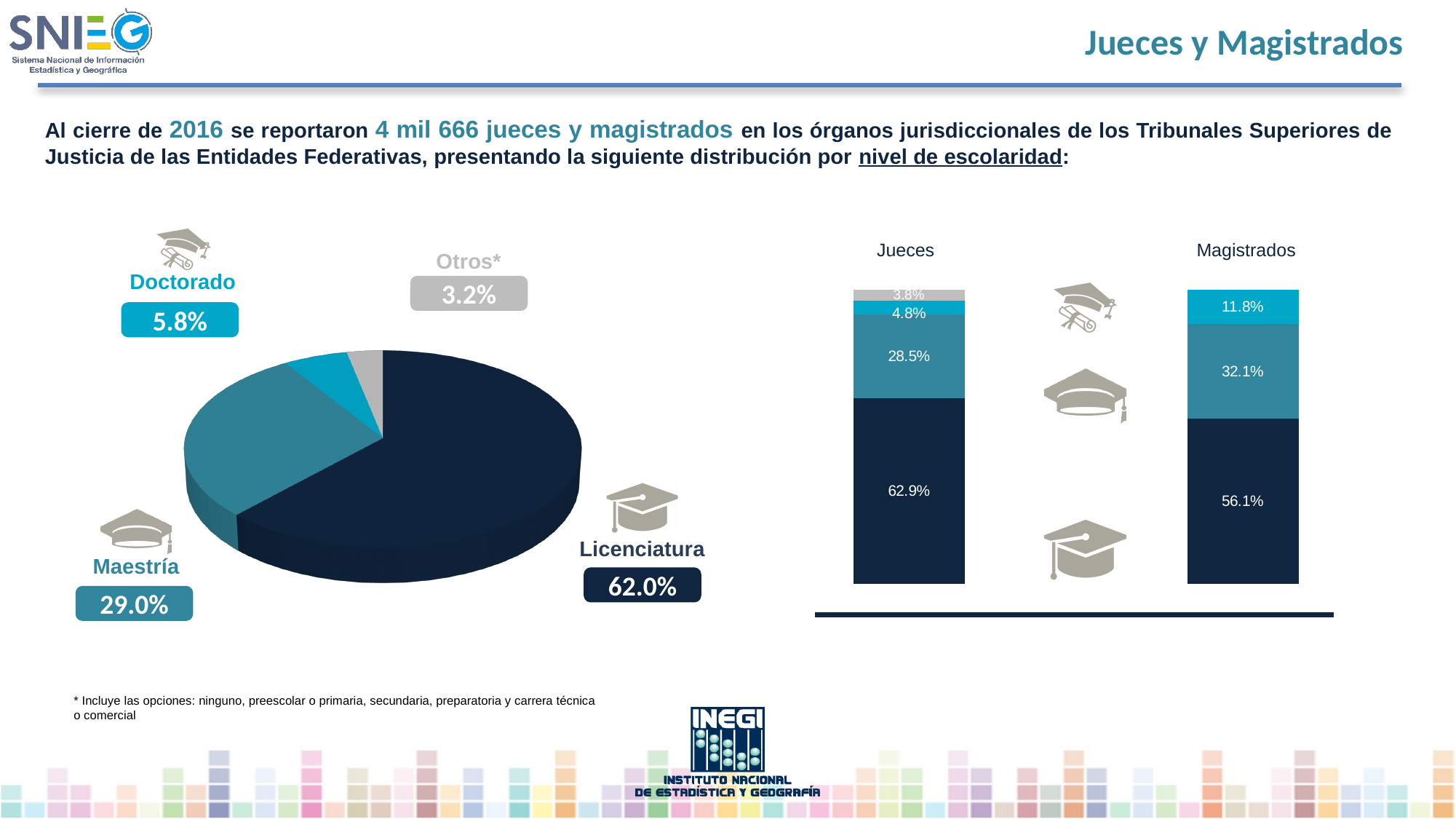
In the pie chart on the left, what percentage corresponds to Maestría? 29.0% In the stacked bar chart on the right, what is the value of the bottom (dark navy) segment for Jueces? 62.9% In the pie chart on the left, what percentage corresponds to Doctorado? 5.8% In the pie chart on the left, which education level has the largest share? Licenciatura In the stacked bar chart on the right, what is the value of the top (light blue) segment for Magistrados? 11.8% What type of chart is shown on the left side of the slide? Pie chart In the stacked bar chart on the right, what is the difference between the teal segment for Magistrados (32.1%) and the teal segment for Jueces (28.5%)? 3.6 percentage points In the pie chart on the left, what share of judges and magistrates have a Licenciatura? 62.0% In the pie chart on the left, which education level has the smallest share? Otros* In the stacked bar chart on the right, which group has the larger bottom (dark navy) segment, Jueces or Magistrados? Jueces In the pie chart on the left, how many percentage points larger is Licenciatura than Maestría? 33.0 percentage points In the pie chart on the left, how many categories are shown? 4